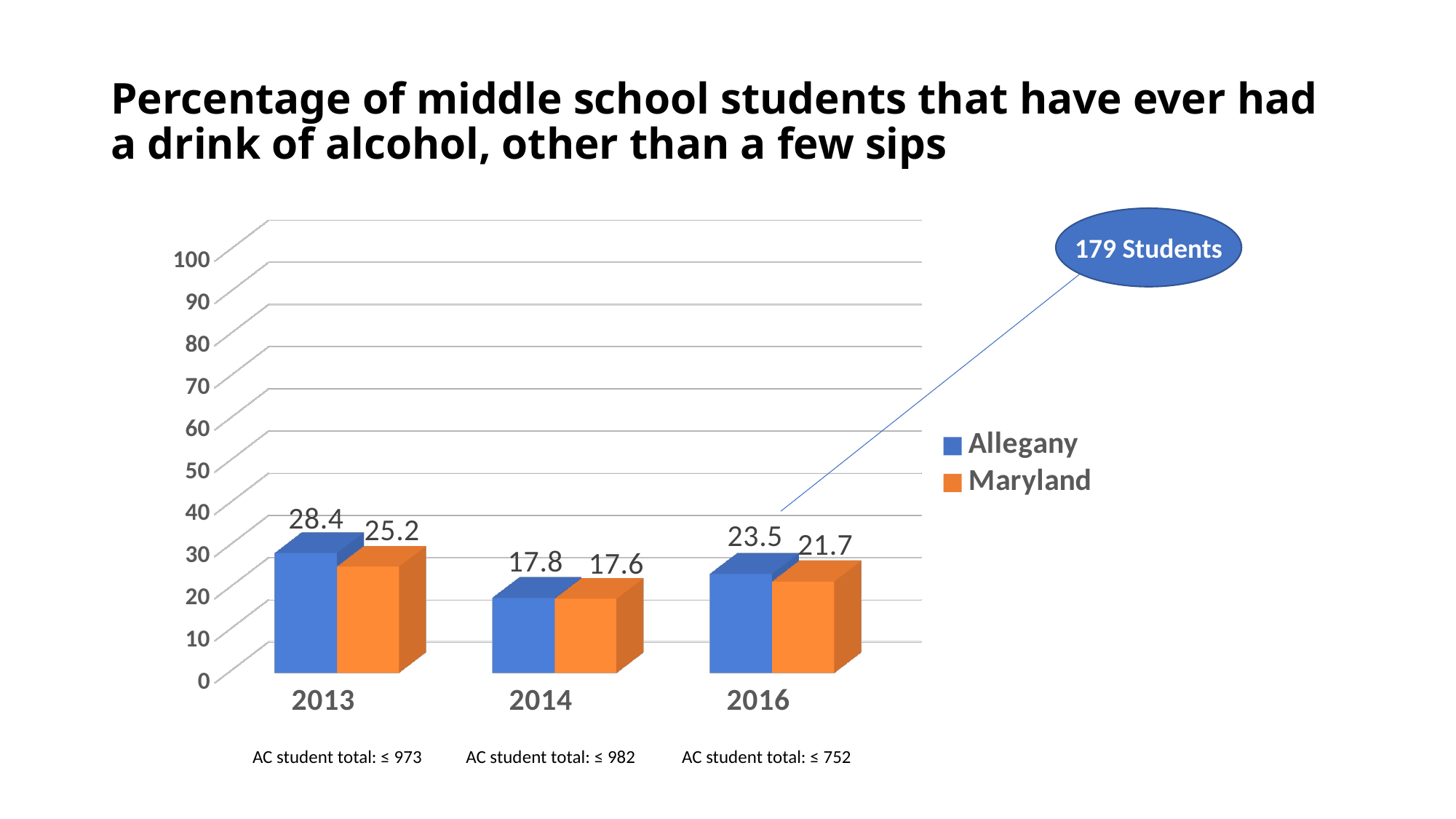
What is the Allegany value for 2013? 28.4 What is the Maryland value for 2016? 21.7 Which is larger in 2016, the Allegany value or the Maryland value? Allegany How many series does the legend list? 2 What is the Maryland value for 2014? 17.6 What is the difference between the Allegany and Maryland values in 2013? 3.2 What does the callout bubble on the slide say? 179 Students In which year is the Maryland value lowest? 2014 What is the Allegany value for 2016? 23.5 What kind of chart is shown on the slide? Bar chart How many years are shown on the x axis? 3 In which year is the Allegany value highest? 2013